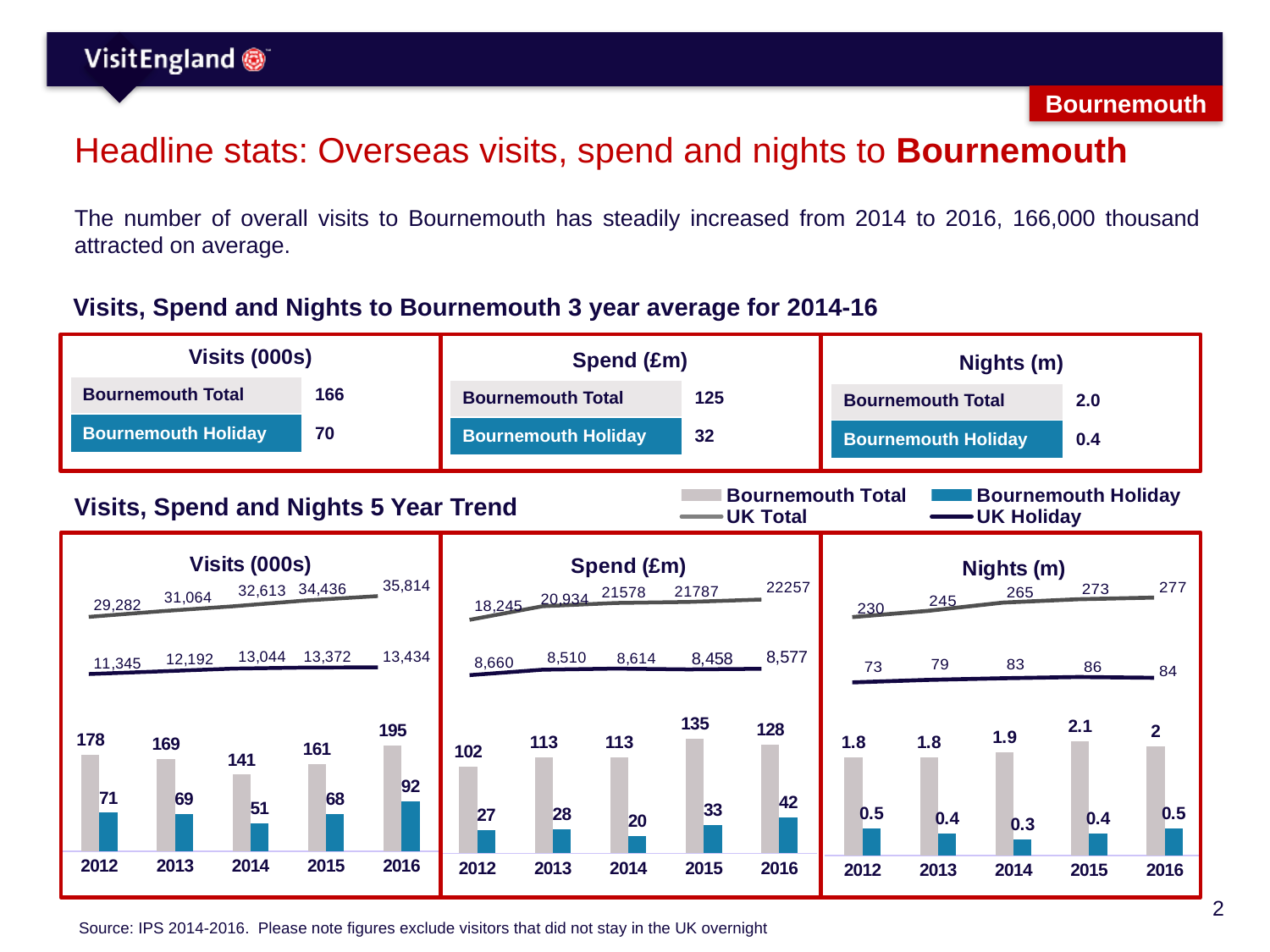
In the Spend (£m) 5 year trend chart, what is the Bournemouth Holiday value for 2016? 42 How many years are shown on the x axis of the Spend (£m) 5 year trend chart? 5 In the Spend (£m) 5 year trend chart, what is the UK Holiday value for 2015? 8,458 In the Nights (m) 5 year trend chart, does the UK Total line rise or fall from 2012 to 2016? rise In the Visits (000s) 5 year trend chart, what is the Bournemouth Total value for 2016? 195 In the Nights (m) 5 year trend chart, what is the Bournemouth Total value for 2015? 2.1 How many series does the legend for the 5 Year Trend charts list? 4 In the Nights (m) 5 year trend chart, which is larger: the Bournemouth Holiday value for 2012 or for 2014? 2012 In the Visits (000s) 5 year trend chart, which year has the lowest Bournemouth Holiday value? 2014 In the Spend (£m) 5 year trend chart, which year has the highest Bournemouth Total value? 2015 In the Visits (000s) 5 year trend chart, what is the UK Total value for 2012? 29,282 In the Visits (000s) 5 year trend chart, what is the difference between the Bournemouth Total values for 2016 and 2014? 54